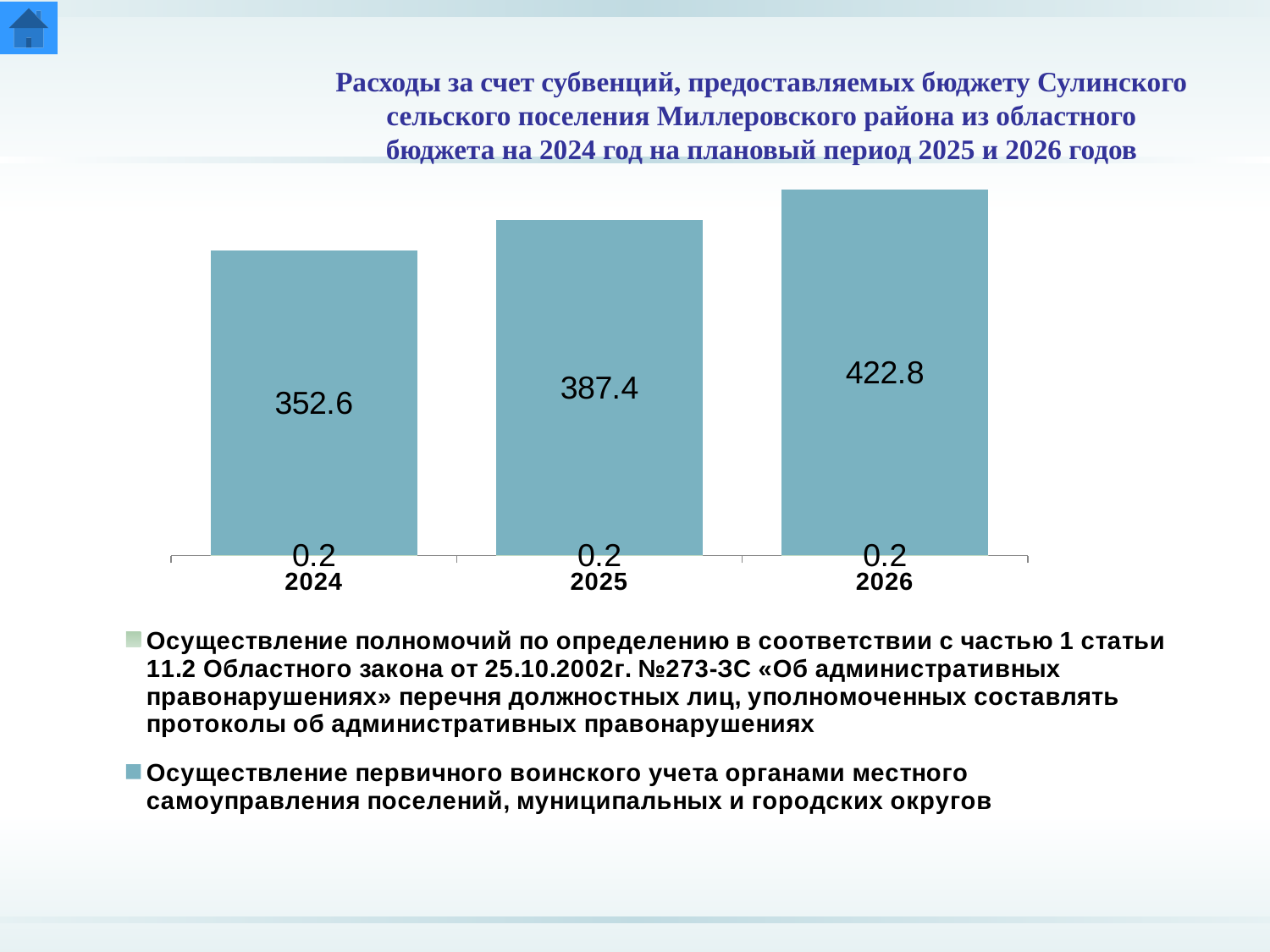
Which is larger: the 2025 or the 2026 value for the series 'Осуществление первичного воинского учета...'? 2026 How many years are shown on the x axis of the chart? 3 Which year has the highest value for the series 'Осуществление первичного воинского учета...'? 2026 What kind of chart is shown on the slide? Bar chart What is the value for 2026 for the series 'Осуществление первичного воинского учета органами местного самоуправления поселений, муниципальных и городских округов'? 422.8 What is the value for 2024 for the series 'Осуществление полномочий по определению в соответствии с частью 1 статьи 11.2 Областного закона...'? 0.2 How many series does the legend list? 2 What is the value for 2024 for the series 'Осуществление первичного воинского учета органами местного самоуправления поселений, муниципальных и городских округов'? 352.6 What is the difference between the 2026 and 2024 values for the series 'Осуществление первичного воинского учета...'? 70.2 Which year has the lowest value for the series 'Осуществление первичного воинского учета...'? 2024 What is the difference between the 2025 and 2024 values for the series 'Осуществление первичного воинского учета...'? 34.8 What is the value for 2025 for the series 'Осуществление первичного воинского учета органами местного самоуправления поселений, муниципальных и городских округов'? 387.4